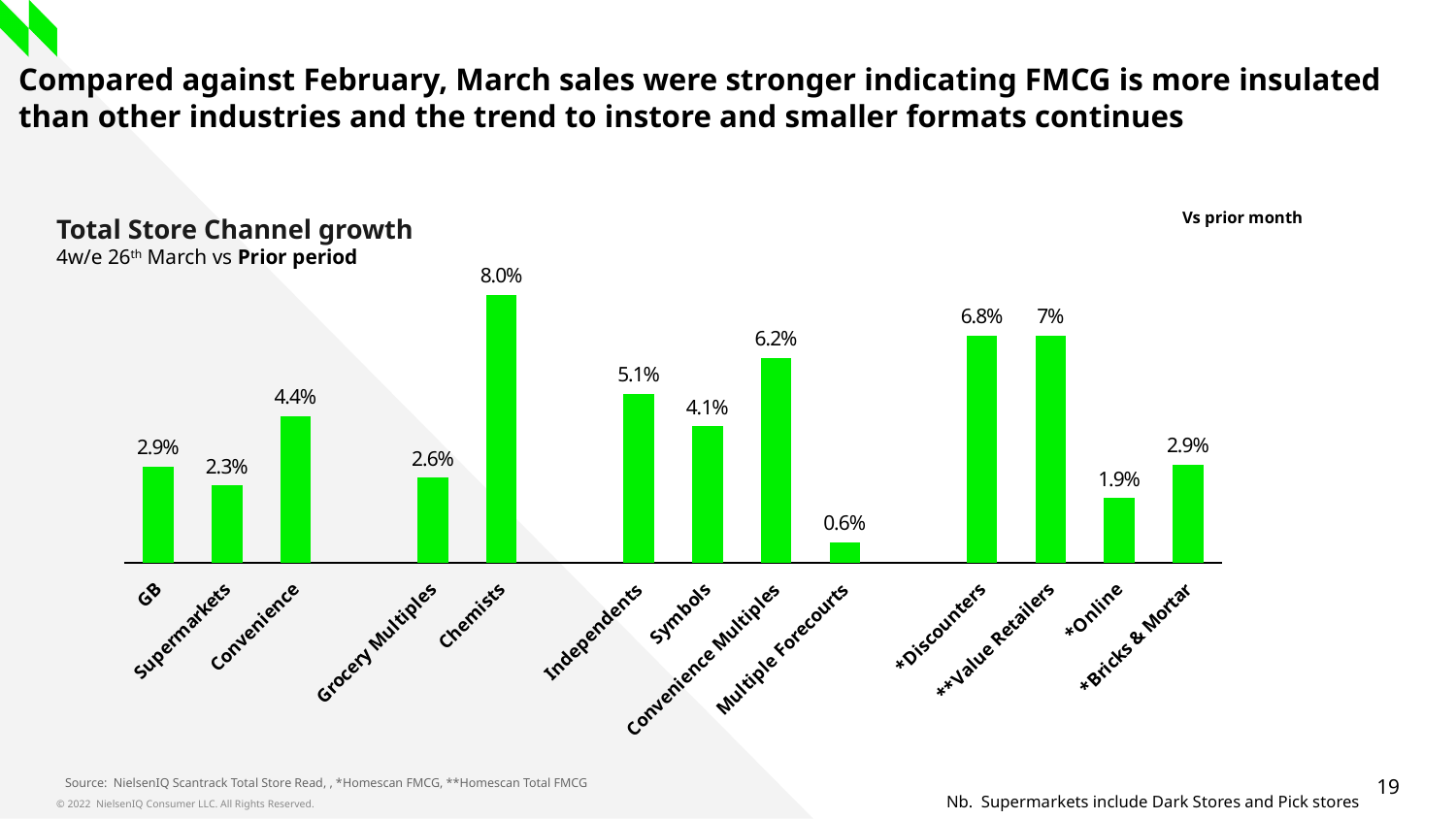
What is the difference between the values for Convenience Multiples and Symbols? 2.1% Which is larger, the value for Convenience or the value for Supermarkets? Convenience What is the title of the chart? Total Store Channel growth How many categories are shown in the chart? 13 What is the value for Chemists? 8.0% What is the value for Multiple Forecourts? 0.6% What kind of chart is shown on the slide? Bar chart What is the difference between the values for Independents and Grocery Multiples? 2.5% Which category has the highest value? Chemists What is the value for **Value Retailers? 7% Which category has the lowest value? Multiple Forecourts What is the value for *Online? 1.9%